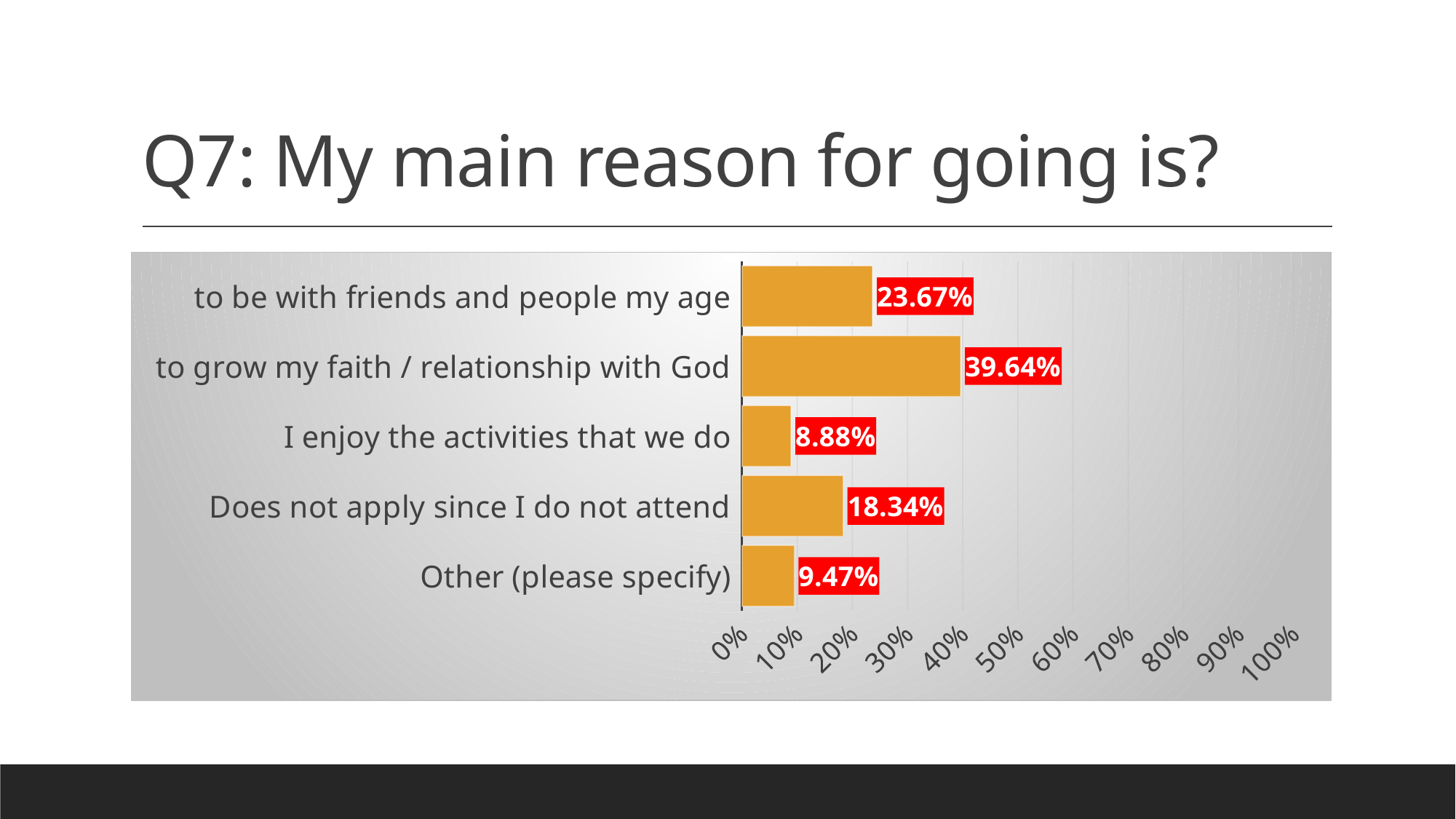
What is the value shown for "Other (please specify)"? 9.47% Is the value for "to be with friends and people my age" greater or less than 20%? greater What is the difference between "to grow my faith / relationship with God" and "to be with friends and people my age"? 15.97% What percentage selected "Does not apply since I do not attend"? 18.34% What is the title of the slide? Q7: My main reason for going is? How many categories are shown in the chart? 5 What percentage of respondents chose "to grow my faith / relationship with God" as their main reason for going? 39.64% Which reason has the highest percentage? to grow my faith / relationship with God Which is larger: "Does not apply since I do not attend" or "I enjoy the activities that we do"? Does not apply since I do not attend What is the value for "to be with friends and people my age"? 23.67% What type of chart is shown on the slide? bar chart Which category has the lowest percentage? I enjoy the activities that we do